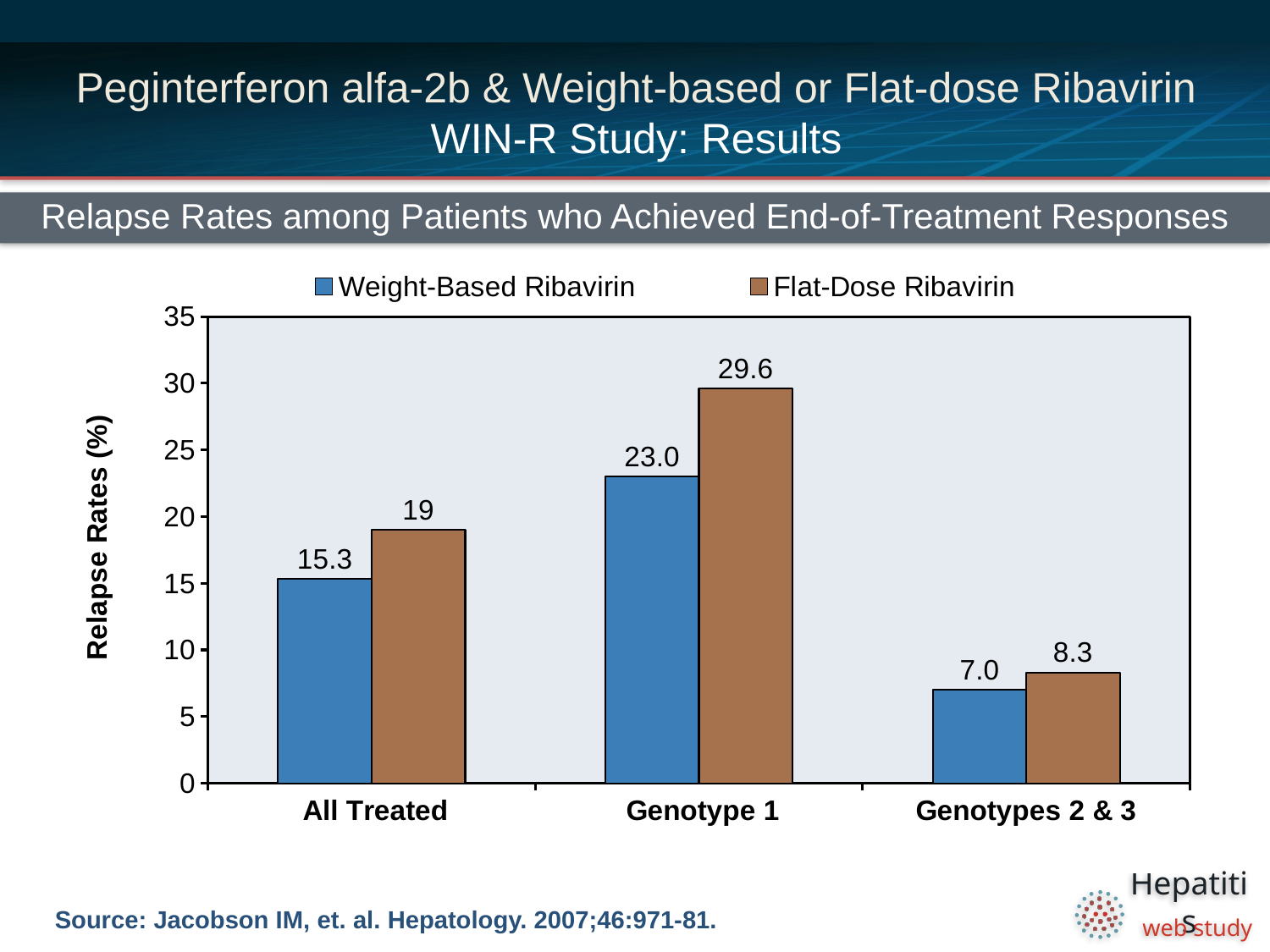
Is the relapse rate for Weight-Based Ribavirin in the Genotype 1 group greater or less than 20? greater In the Genotypes 2 & 3 group, which has the higher relapse rate: Weight-Based Ribavirin or Flat-Dose Ribavirin? Flat-Dose Ribavirin What is the difference between the Flat-Dose and Weight-Based Ribavirin relapse rates in the Genotype 1 group? 6.6 What kind of chart is shown on the slide? Bar chart What is the relapse rate for Weight-Based Ribavirin in the Genotypes 2 & 3 group? 7.0 Which group has the lowest relapse rate for Weight-Based Ribavirin? Genotypes 2 & 3 How many series does the legend list? 2 What is the relapse rate for Flat-Dose Ribavirin in the All Treated group? 19 Which group has the highest relapse rate for Flat-Dose Ribavirin? Genotype 1 How many patient groups are shown on the x axis? 3 What is the relapse rate for Weight-Based Ribavirin in the All Treated group? 15.3 What is the relapse rate for Flat-Dose Ribavirin in the Genotype 1 group? 29.6